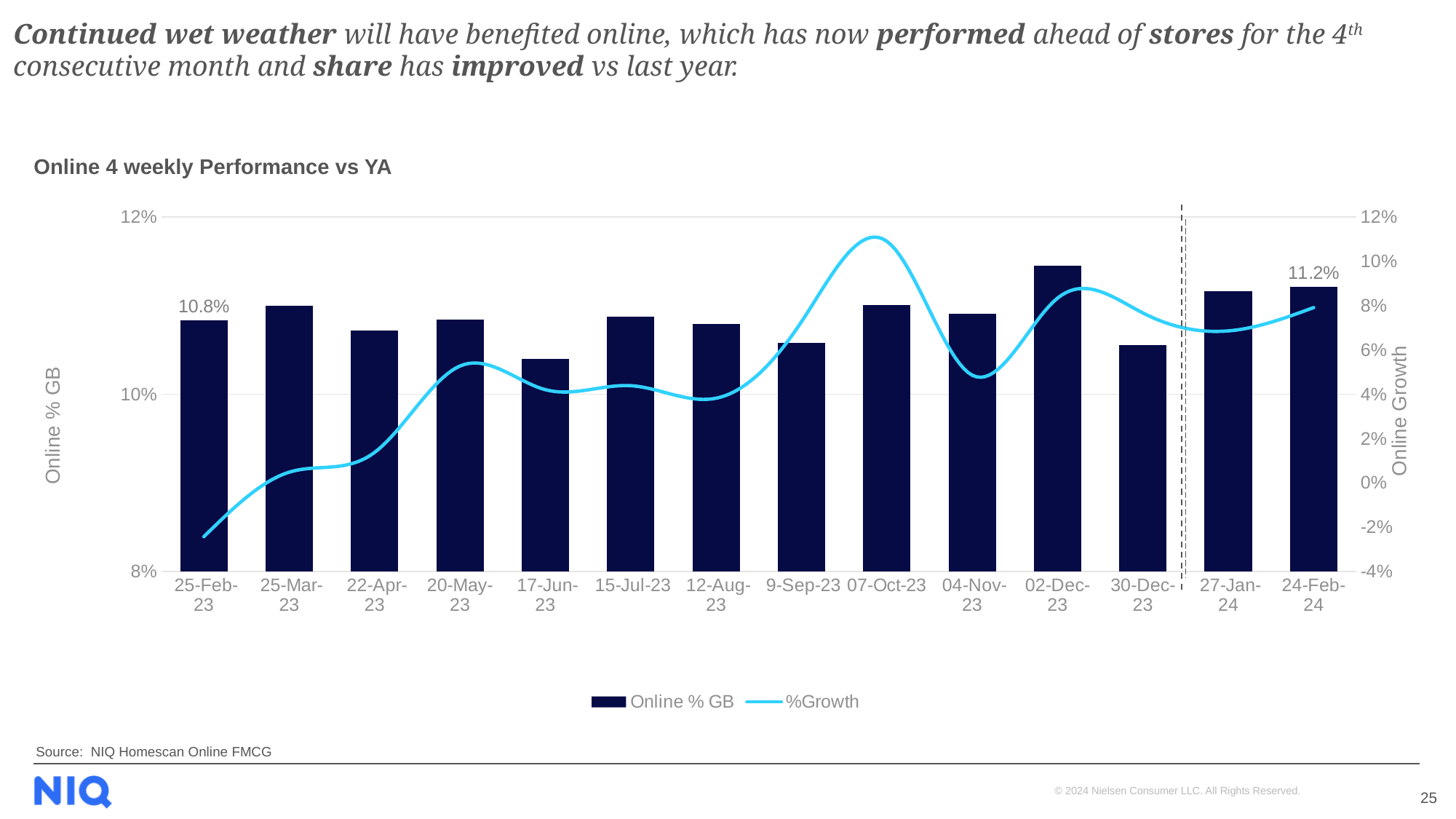
Is the Online % GB value for 02-Dec-23 greater or less than 11%? greater What is the Online % GB value for 24-Feb-24? 11.2% How many series does the legend list? 2 At which period does the %Growth line reach its highest point? 07-Oct-23 Which period has the highest Online % GB bar? 02-Dec-23 At which period is the %Growth line at its lowest point? 25-Feb-23 Which has the larger Online % GB bar, 02-Dec-23 or 30-Dec-23? 02-Dec-23 By how many percentage points is the Online % GB value for 24-Feb-24 higher than for 25-Feb-23? 0.4 percentage points How many periods are shown on the x axis? 14 What is the Online % GB value for 25-Feb-23? 10.8% Is the %Growth value for 25-Feb-23 greater or less than 0%? less Which period has the lowest Online % GB bar? 17-Jun-23